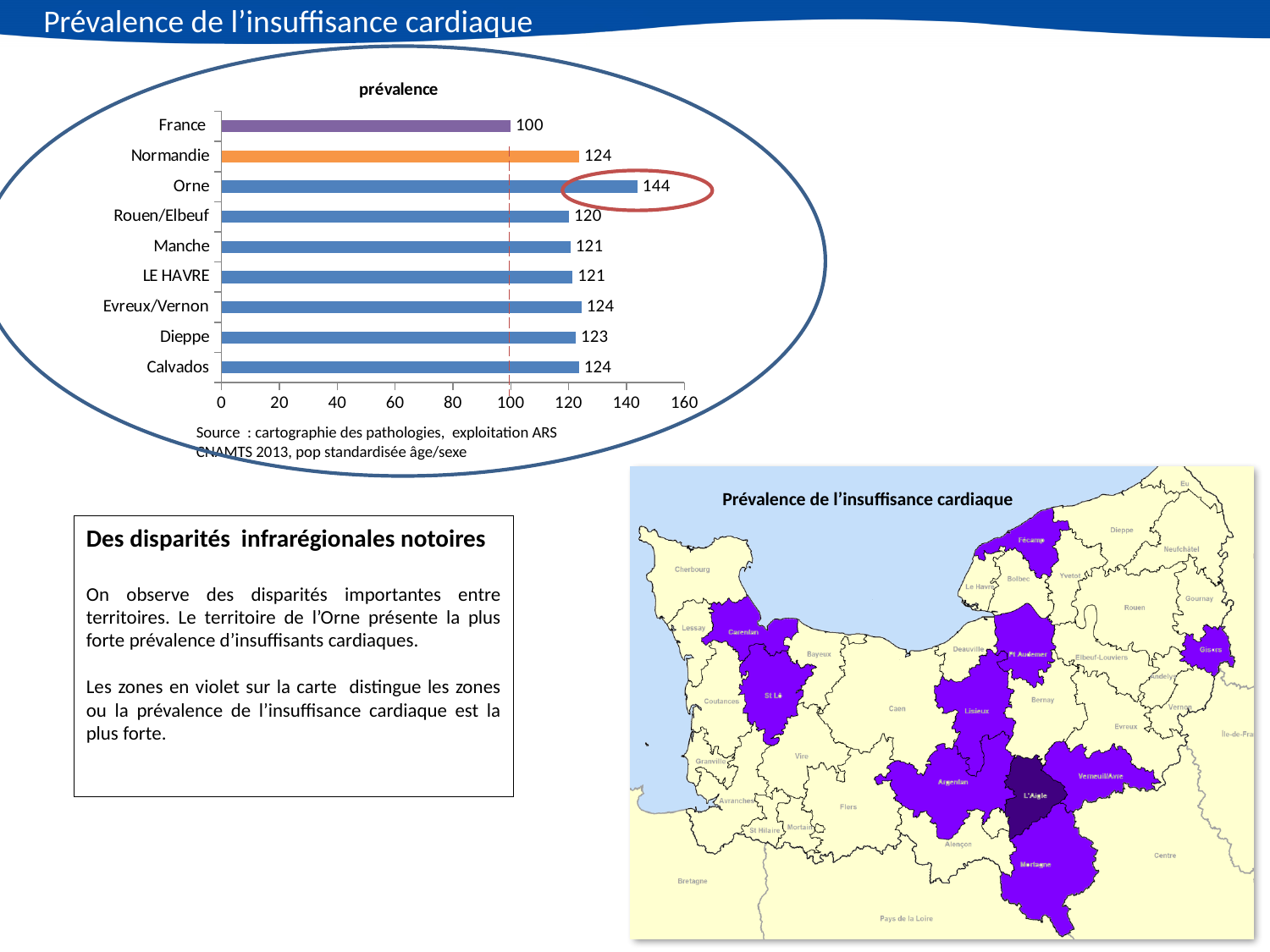
Which category has the lowest prevalence value in the bar chart? France Is the prevalence value for Orne greater or less than 140? greater What is the difference between the prevalence values for Orne and Normandie? 20 Which category has the highest prevalence value in the bar chart? Orne What is the prevalence value shown for Orne? 144 What is the prevalence value shown for Rouen/Elbeuf? 120 What kind of chart is used to show the prevalence values? Bar chart How many categories are shown in the bar chart? 9 What is the prevalence value shown for Dieppe? 123 What is the difference between the prevalence values for Orne and France? 44 What is the prevalence value shown for Normandie? 124 Which has a larger prevalence value, Orne or Calvados? Orne